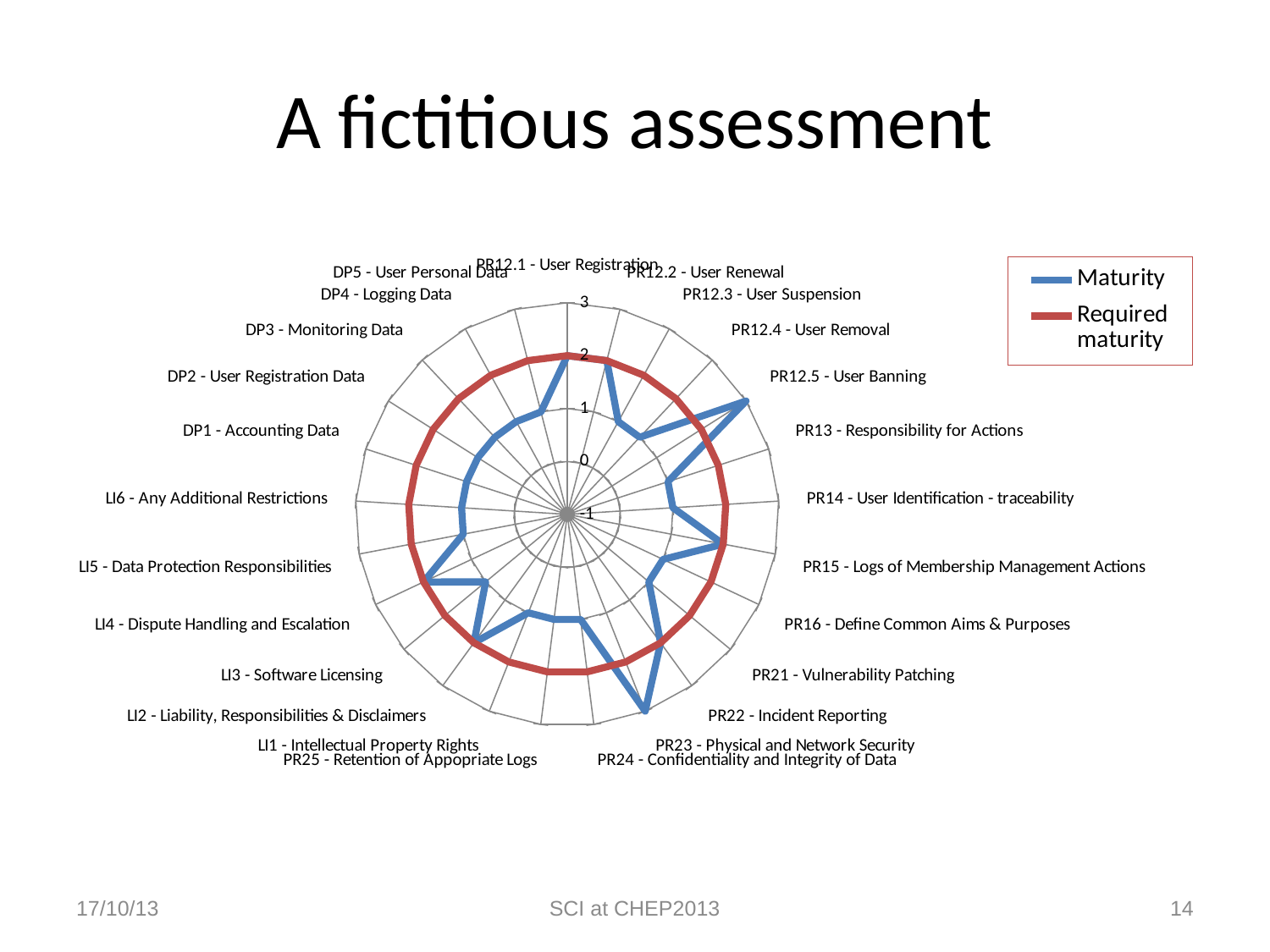
Is the Maturity value for PR12.3 - User Suspension greater or less than 2? less What kind of chart is shown on the slide? radar chart What is the Maturity value for PR22 - Incident Reporting? 2 What are the two series named in the legend? Maturity and Required maturity What is the Maturity value for PR12.5 - User Banning? 3 How many series does the legend list? 2 Which is larger for PR16 - Define Common Aims & Purposes: the Maturity value or the Required maturity value? Required maturity Is the Maturity value for PR14 - User Identification - traceability greater or less than 2? less What is the Required maturity value for PR13 - Responsibility for Actions? 2 What is the title of the slide containing the chart? A fictitious assessment How many categories are plotted around the radar chart? 25 What is the Required maturity value for LI3 - Software Licensing? 2